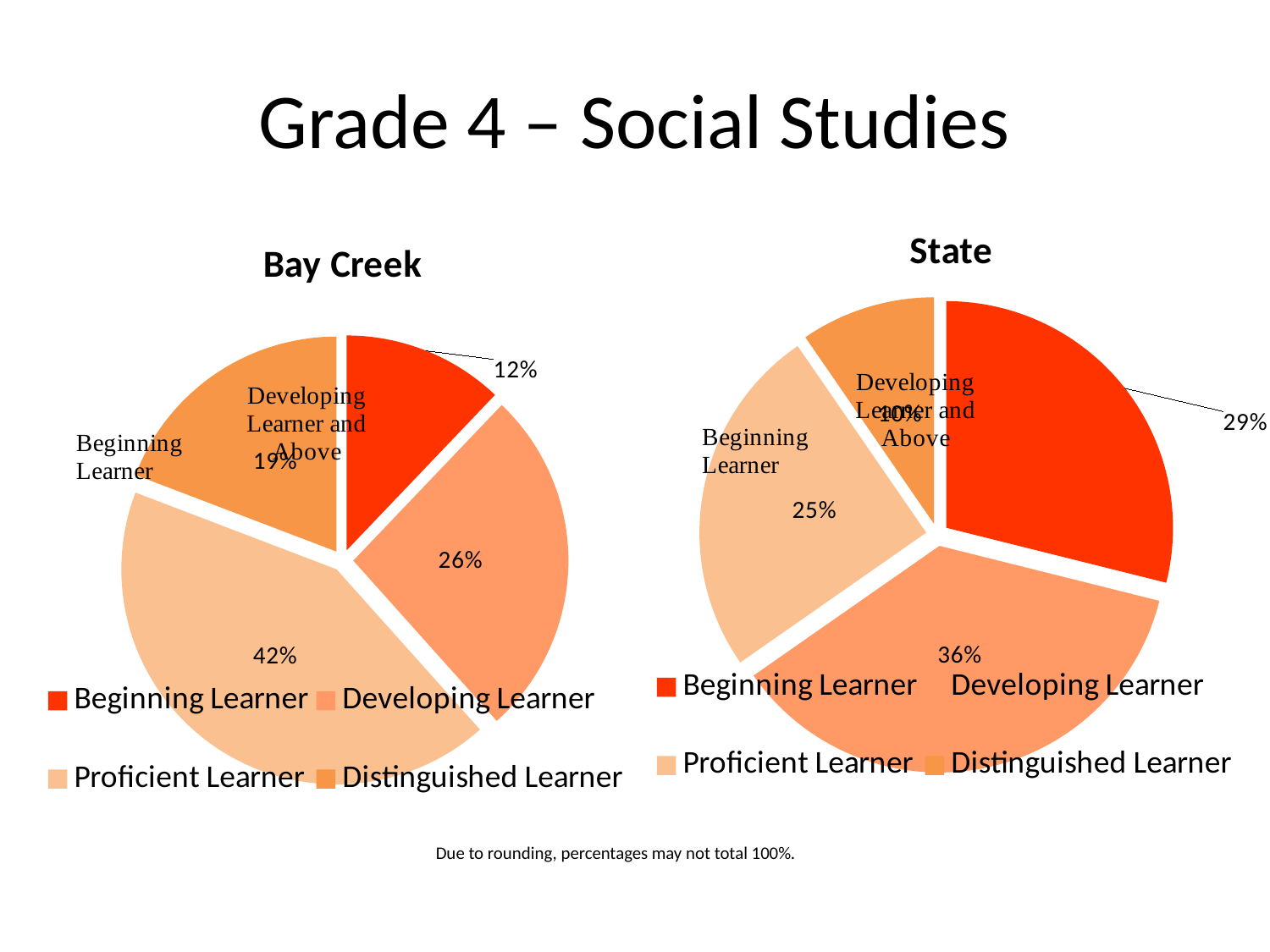
How many categories does the legend of the State chart list? 4 In the Bay Creek chart, what percentage is shown for Beginning Learner? 12% In the State chart, what percentage is shown for Distinguished Learner? 10% Which is larger: Proficient Learner in the Bay Creek chart or Proficient Learner in the State chart? Bay Creek In the Bay Creek chart, what percentage is shown for Proficient Learner? 42% In the State chart, what percentage is shown for Developing Learner? 36% In the Bay Creek chart, which category has the smallest slice? Beginning Learner What is the title of the slide? Grade 4 – Social Studies In the Bay Creek chart, which category has the largest slice? Proficient Learner What type of chart is the Bay Creek chart? Pie chart In the State chart, which category has the smallest slice? Distinguished Learner What is the difference between the Beginning Learner percentage in the State chart and in the Bay Creek chart? 17%